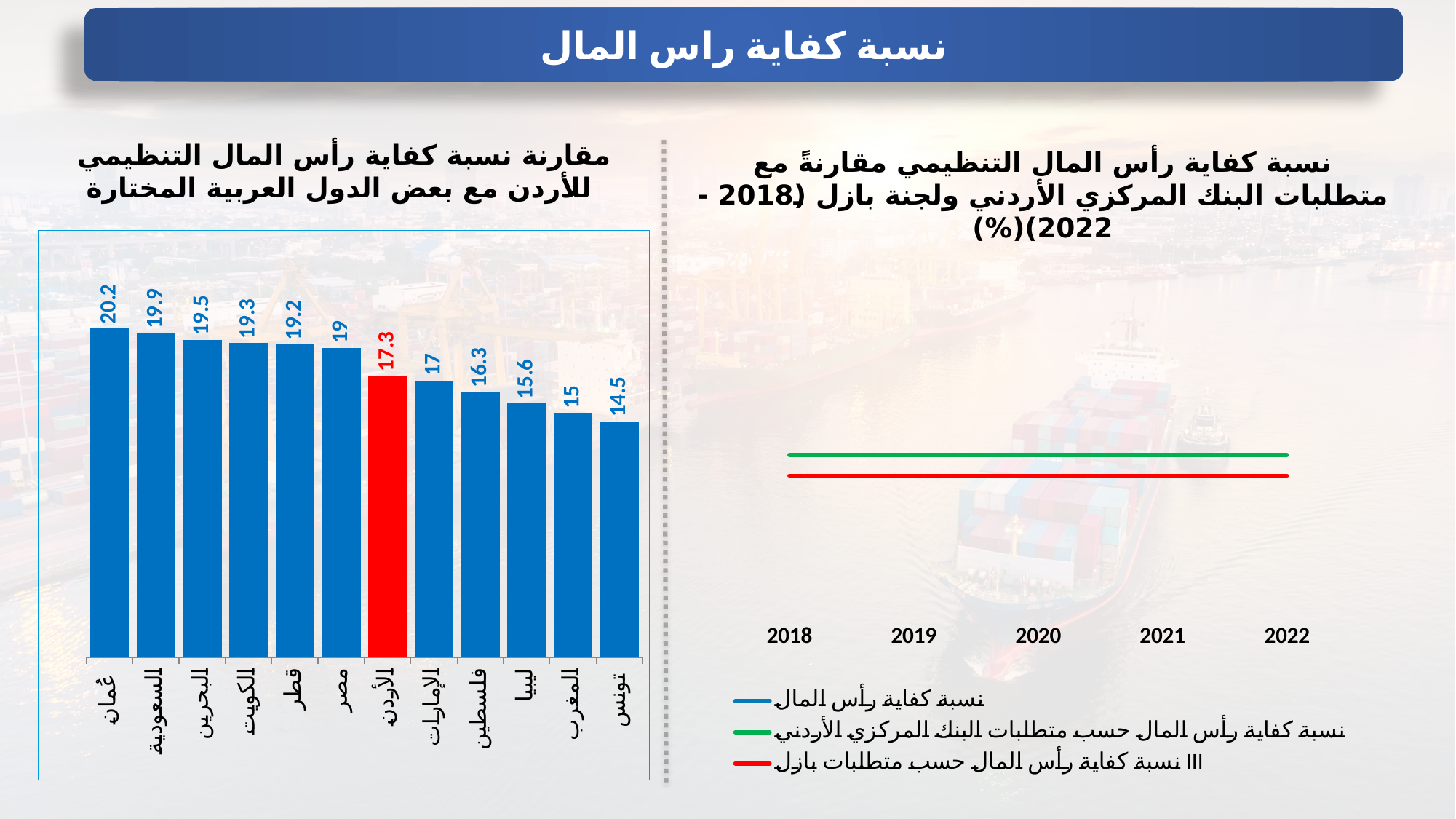
In the left bar chart comparing Jordan's regulatory capital adequacy ratio with selected Arab countries, how many countries are shown? 12 In the right chart comparing the regulatory capital adequacy ratio with the Central Bank of Jordan and Basel requirements (2018-2022), how many series does the legend list? 3 In the right chart comparing the regulatory capital adequacy ratio with the Central Bank of Jordan and Basel requirements, how many years are shown on the x axis? 5 In the left bar chart comparing Jordan's regulatory capital adequacy ratio with selected Arab countries, what is the value for الأردن (Jordan)? 17.3 In the left bar chart comparing Jordan's regulatory capital adequacy ratio with selected Arab countries, which is larger, the value for الإمارات or the value for فلسطين? الإمارات In the left bar chart comparing Jordan's regulatory capital adequacy ratio with selected Arab countries, what is the difference between the values for عمان and تونس? 5.7 In the left bar chart comparing Jordan's regulatory capital adequacy ratio with selected Arab countries, which country has the highest value? عمان What kind of chart is the left chart comparing Jordan's regulatory capital adequacy ratio with selected Arab countries? bar chart In the left bar chart comparing Jordan's regulatory capital adequacy ratio with selected Arab countries, which country's bar is coloured red? الأردن In the right chart comparing the regulatory capital adequacy ratio with the Central Bank of Jordan and Basel requirements, what colour is the line for the Basel requirement (نسبة كفاية رأس المال حسب متطلبات بازل III)? red In the left bar chart comparing Jordan's regulatory capital adequacy ratio with selected Arab countries, what is the value for السعودية (Saudi Arabia)? 19.9 In the left bar chart comparing Jordan's regulatory capital adequacy ratio with selected Arab countries, which country has the lowest value? تونس